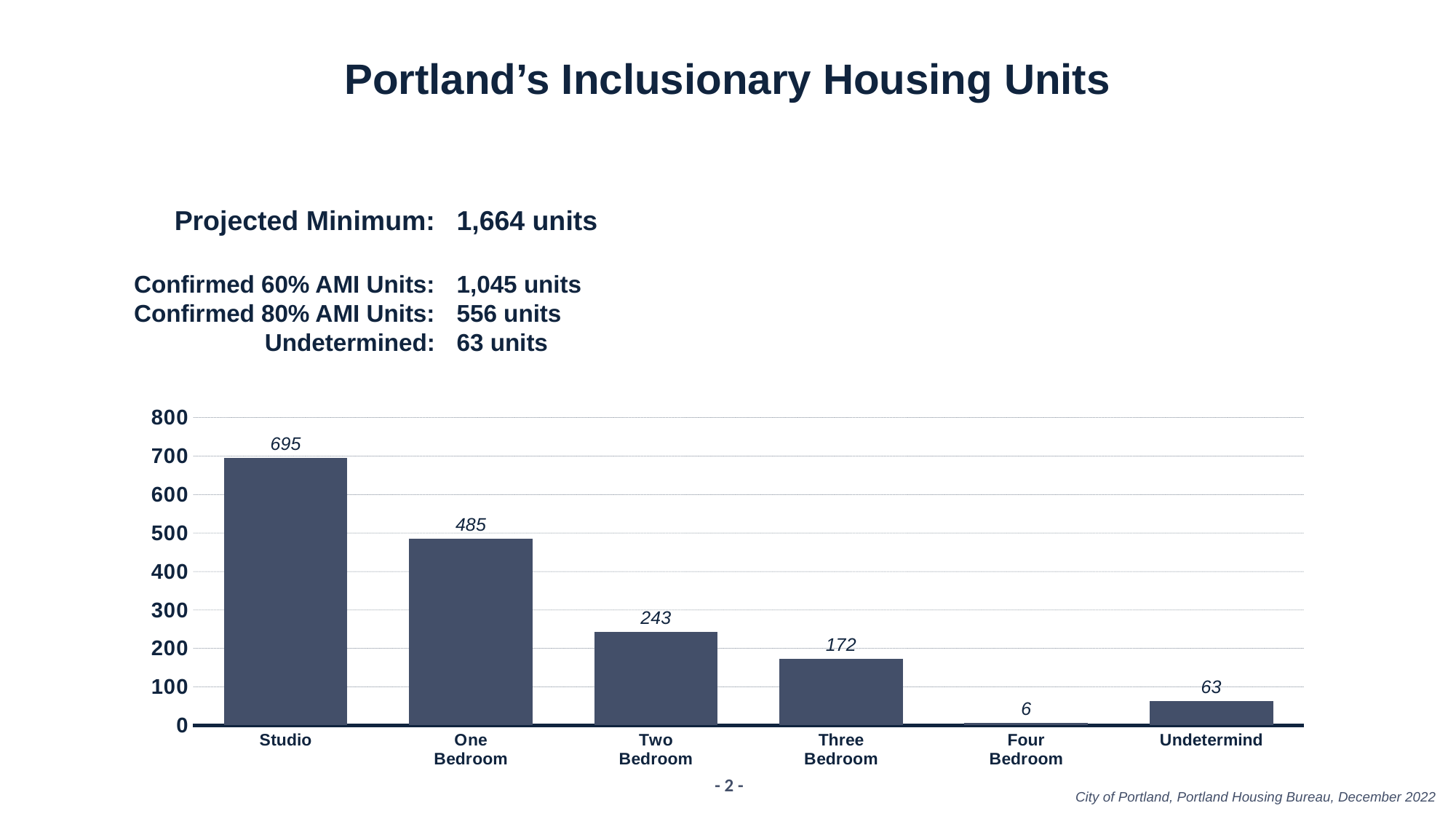
Which is larger, Two Bedroom or Three Bedroom? Two Bedroom What is the difference between the Studio and One Bedroom values? 210 Do the values rise or fall from Studio to Four Bedroom? fall What is the difference between the Three Bedroom and Undetermind values? 109 How many categories are shown on the x axis? 6 How many units are shown for Studio? 695 What kind of chart is shown on the slide? bar chart What is the value for Four Bedroom? 6 What is the value for Two Bedroom? 243 Is the value for One Bedroom greater or less than 400? greater Which category has the lowest value? Four Bedroom Which category has the highest value? Studio